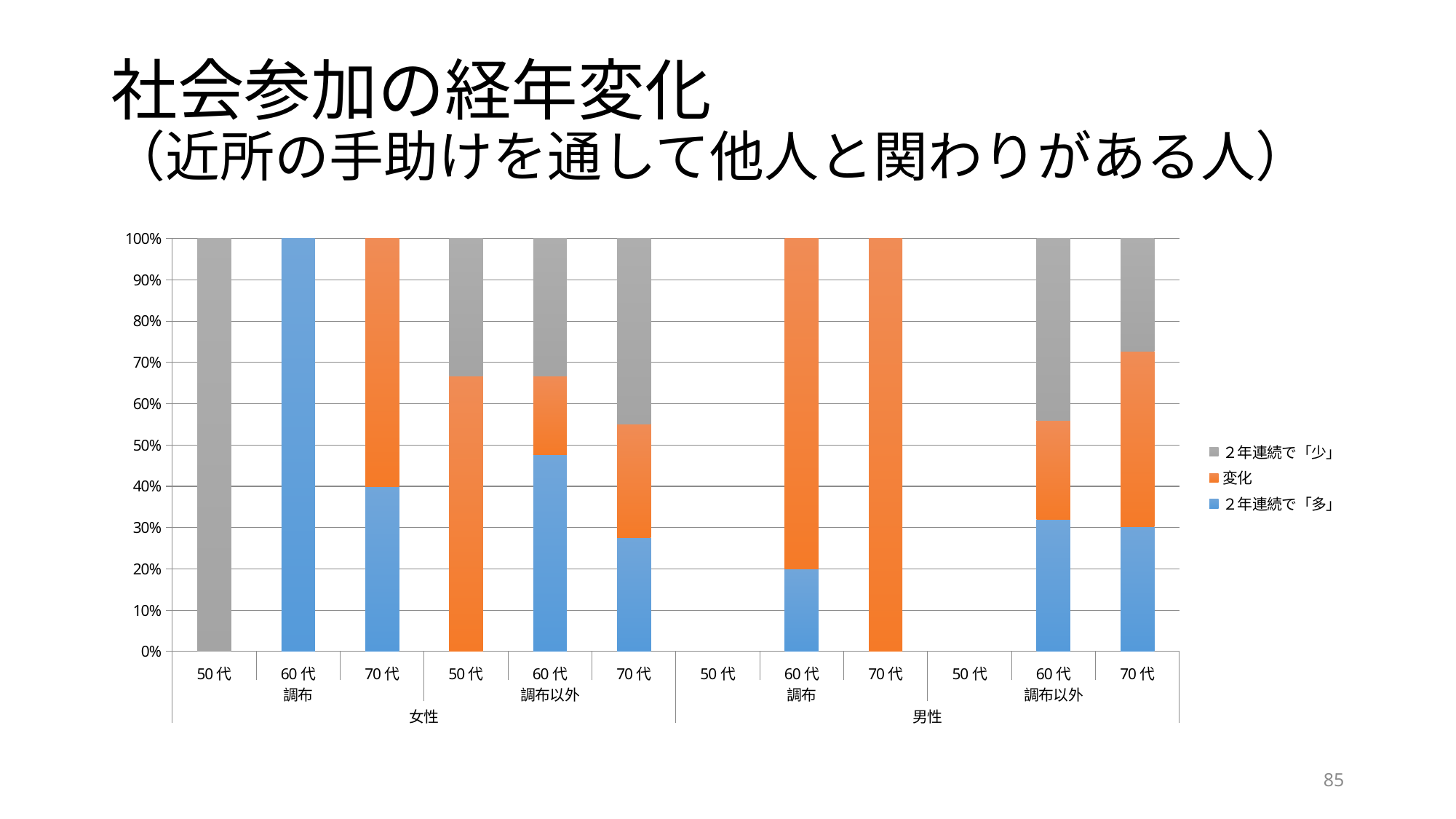
What is the value of 2年連続で「多」 for 女性 調布 60代? 100% What is the value of 2年連続で「少」 for 女性 調布 50代? 100% How many age-group categories are shown along the x axis? 12 Which series is shown in orange in the legend? 変化 What is the value of 変化 for 男性 調布 70代? 100% Is the value of 2年連続で「多」 for 女性 調布以外 60代 greater or less than 40%? greater Which is larger, the 2年連続で「多」 share for 女性 調布以外 60代 or for 男性 調布以外 60代? 女性 調布以外 60代 Is the value of 2年連続で「多」 for 男性 調布 60代 greater or less than 30%? less Which series is shown in gray in the legend? 2年連続で「少」 Is the value of 2年連続で「多」 for 女性 調布以外 70代 greater or less than 20%? greater How many series does the legend list? 3 What kind of chart is shown on the slide? stacked bar chart